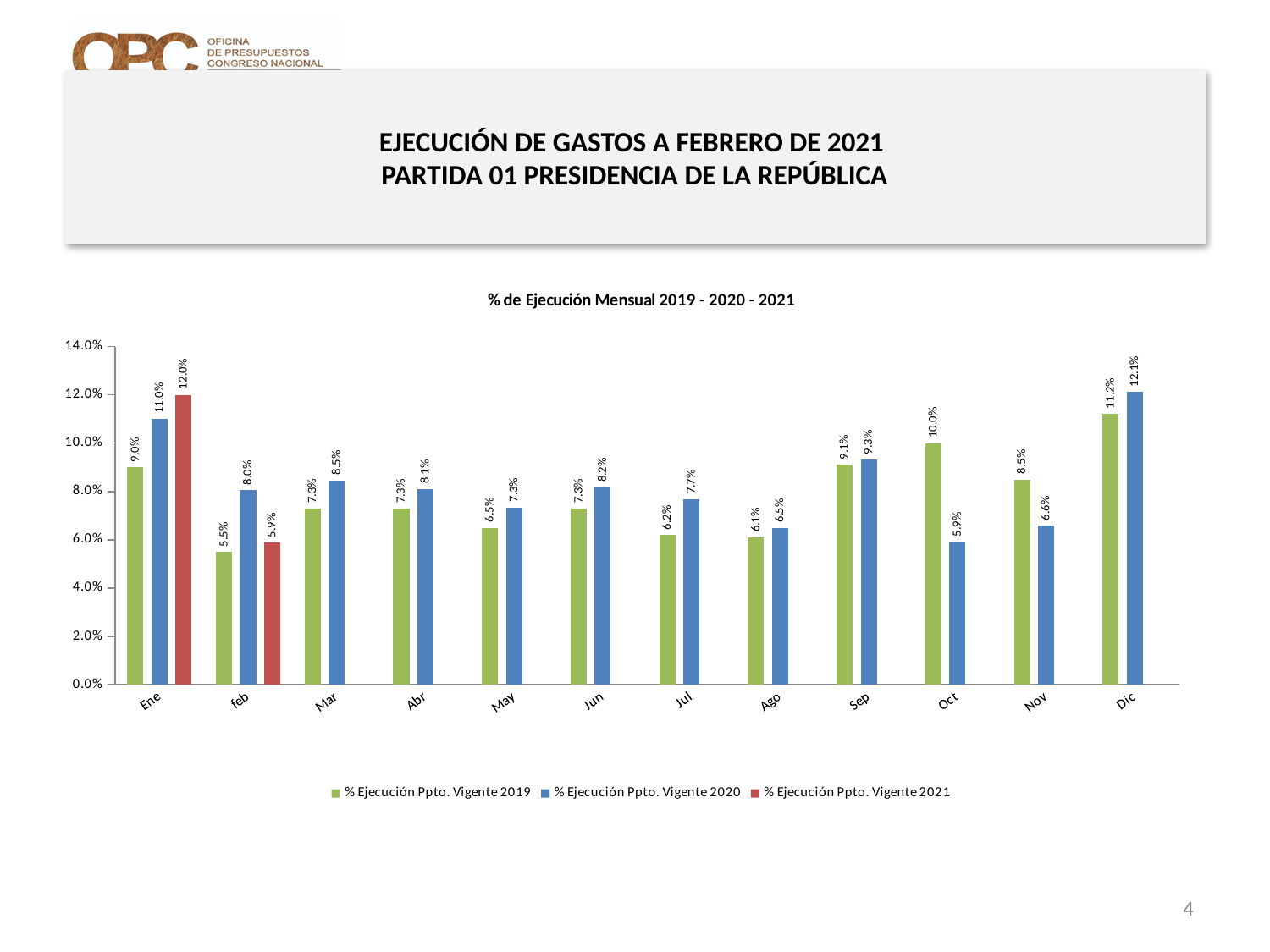
What colour are the bars for % Ejecución Ppto. Vigente 2021? Red Which month has the lowest value for % Ejecución Ppto. Vigente 2019? feb How many months are shown on the x axis? 12 What is the difference between the 2020 and 2019 values in Ene? 2.0% In Oct, which is larger: the 2019 value or the 2020 value? 2019 What is the value for % Ejecución Ppto. Vigente 2019 in Oct? 10.0% What kind of chart is shown? Bar chart What is the value for % Ejecución Ppto. Vigente 2021 in Ene? 12.0% Which month has the highest value for % Ejecución Ppto. Vigente 2020? Dic What is the title of the chart? % de Ejecución Mensual 2019 - 2020 - 2021 What is the value for % Ejecución Ppto. Vigente 2020 in Nov? 6.6% How many series does the legend list? 3